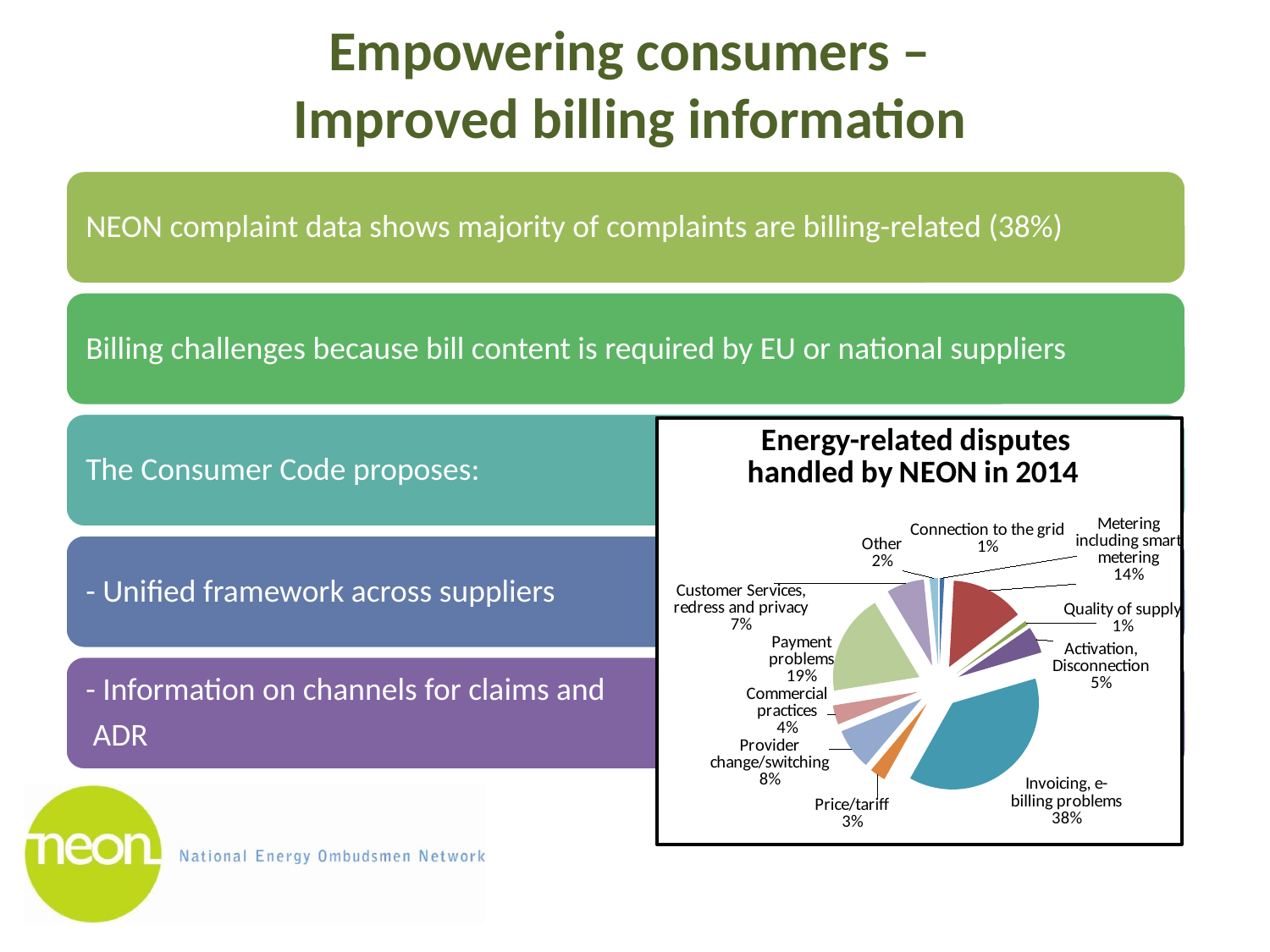
What is the title of the chart? Energy-related disputes handled by NEON in 2014 What share of disputes is attributed to Invoicing, e-billing problems? 38% Which is larger, the share for Commercial practices or the share for Price/tariff? Commercial practices Which category has the largest share of disputes? Invoicing, e-billing problems What is the combined share of Other and Connection to the grid? 3% What share of disputes is attributed to Provider change/switching? 8% What share of disputes is attributed to Metering including smart metering? 14% What share of disputes is attributed to Activation, Disconnection? 5% What kind of chart is shown on the slide? Pie chart What is the difference in percentage points between Payment problems and Customer Services, redress and privacy? 12 What share of disputes is attributed to Payment problems? 19% How many categories are shown in the pie chart? 11